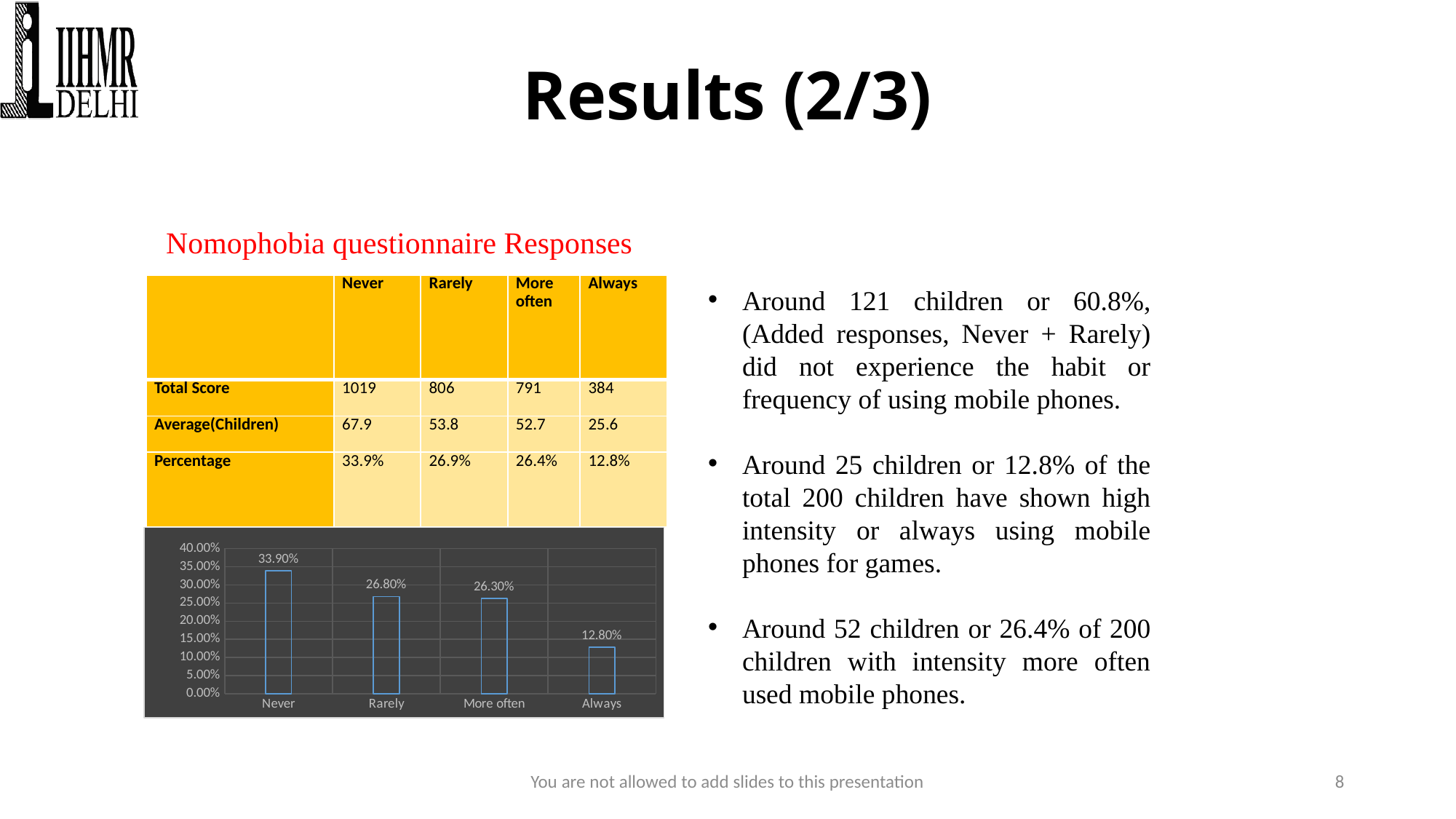
Which is larger in the chart, the value for Never or the value for Rarely? Never Do the values in the chart rise or fall from Never to Always along the x axis? fall What is the value for More often in the chart? 26.30% How many categories are shown on the x axis of the chart? 4 Which category has the highest value in the chart? Never Which category has the lowest value in the chart? Always What is the difference between the values for Never and Always in the chart? 21.10% What is the value for Never in the chart? 33.90% What kind of chart is shown on the slide? bar chart Is the value for Always in the chart greater or less than 15.00%? less What is the value for Rarely in the chart? 26.80% What is the value for Always in the chart? 12.80%